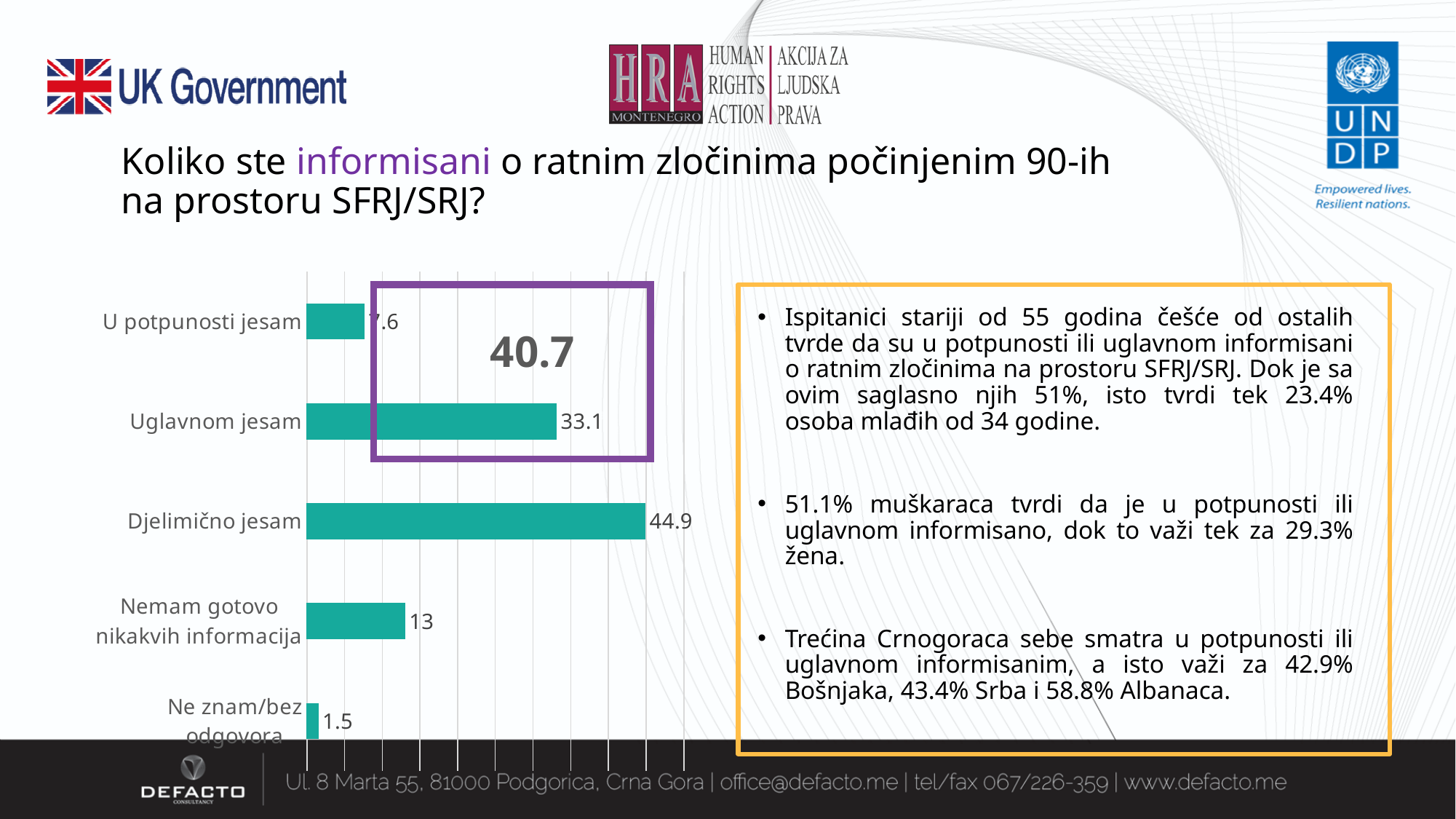
Which category has the lowest value? Ne znam/bez odgovora What colour are the bars in the chart? Teal Which is larger, the value for "Nemam gotovo nikakvih informacija" or the value for "U potpunosti jesam"? Nemam gotovo nikakvih informacija What is the difference between the values for "Djelimično jesam" and "Uglavnom jesam"? 11.8 How many categories are shown in the chart? 5 What kind of chart is shown on the slide? Bar chart Which category has the highest value? Djelimično jesam What is the value for "Nemam gotovo nikakvih informacija"? 13 What is the value for "U potpunosti jesam"? 7.6 What is the value for "Uglavnom jesam"? 33.1 What is the combined value of "U potpunosti jesam" and "Uglavnom jesam", as highlighted in the purple box? 40.7 What is the value for "Djelimično jesam"? 44.9